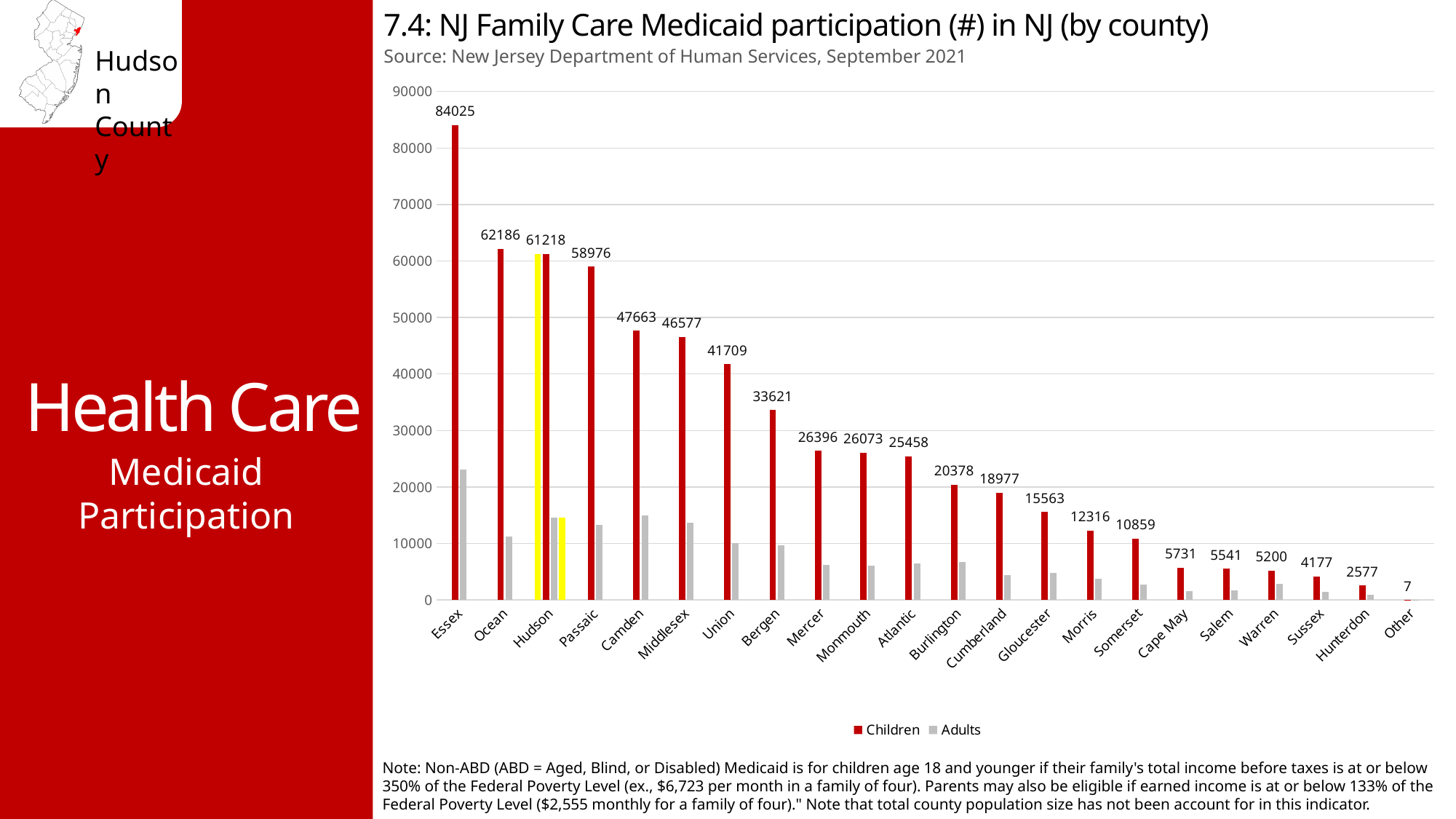
What type of chart is shown? Bar chart Is the Adults value for Essex greater or less than 20000? greater What is the difference between the Children values for Ocean and Hudson? 968 Is the Adults value for Hudson greater or less than 10000? greater What is the Children value for Bergen county? 33621 Which category has the lowest Children value? Other How many categories are shown on the x axis? 22 What is the Children value for Hudson county? 61218 How many series does the legend list? 2 What is the Children value for Essex county? 84025 Which county has the highest Children value? Essex Which has a larger Children value, Camden or Union? Camden